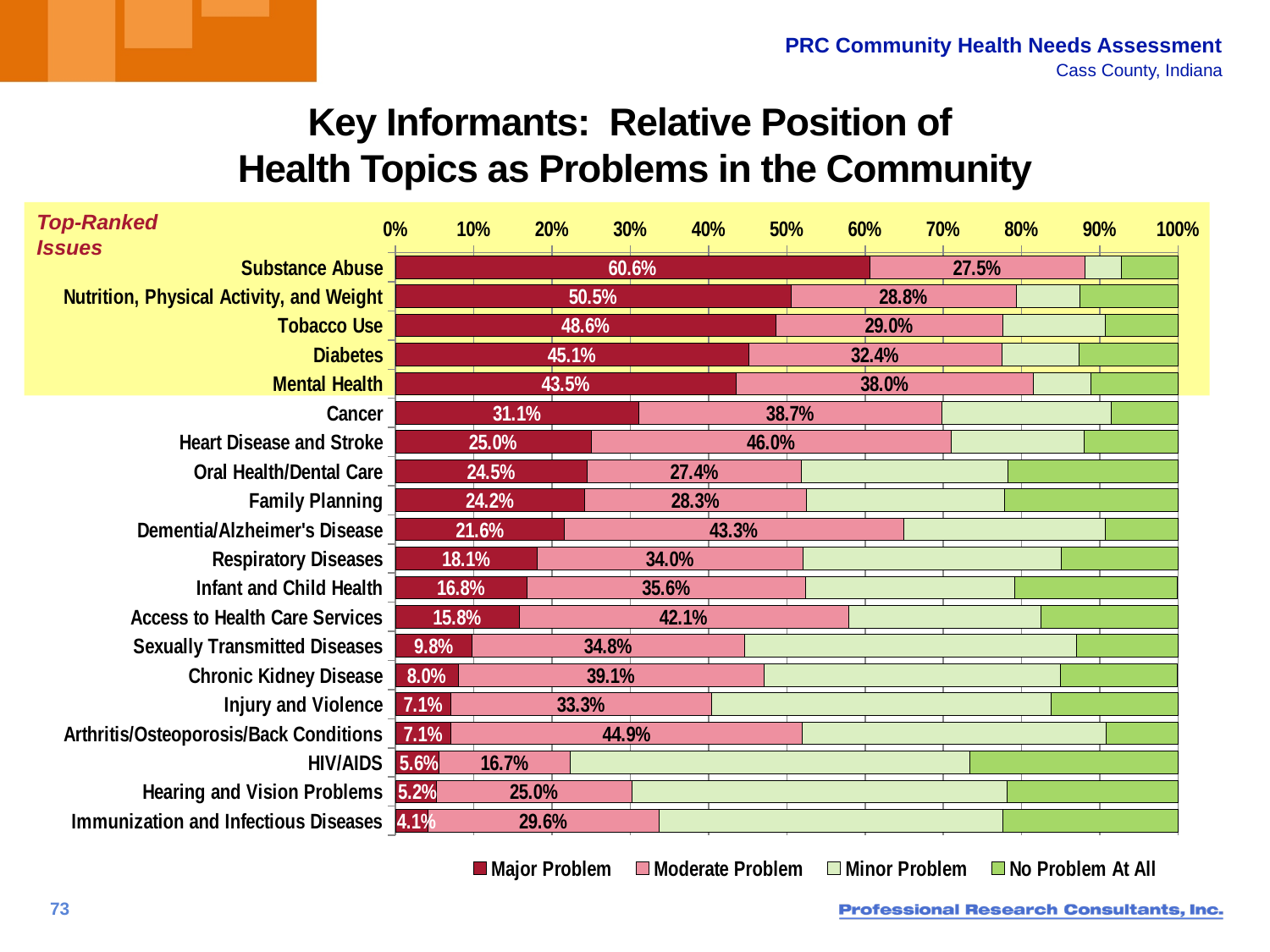
What is the Moderate Problem value for Heart Disease and Stroke? 46.0% What is the Major Problem value for Diabetes? 45.1% What percentage of key informants rated Substance Abuse as a Major Problem? 60.6% Which health topic has the lowest Moderate Problem percentage? HIV/AIDS Is the No Problem At All value for HIV/AIDS greater or less than 20%? greater What is the difference in Major Problem percentage between Substance Abuse and Tobacco Use? 12.0 percentage points Which health topic has the highest Major Problem percentage? Substance Abuse Which health topic has the lowest Major Problem percentage? Immunization and Infectious Diseases How many series does the legend list? 4 What type of chart is shown on the slide? Stacked bar chart Which has a larger Moderate Problem value: Arthritis/Osteoporosis/Back Conditions or Injury and Violence? Arthritis/Osteoporosis/Back Conditions How many health topics are plotted on the chart? 20